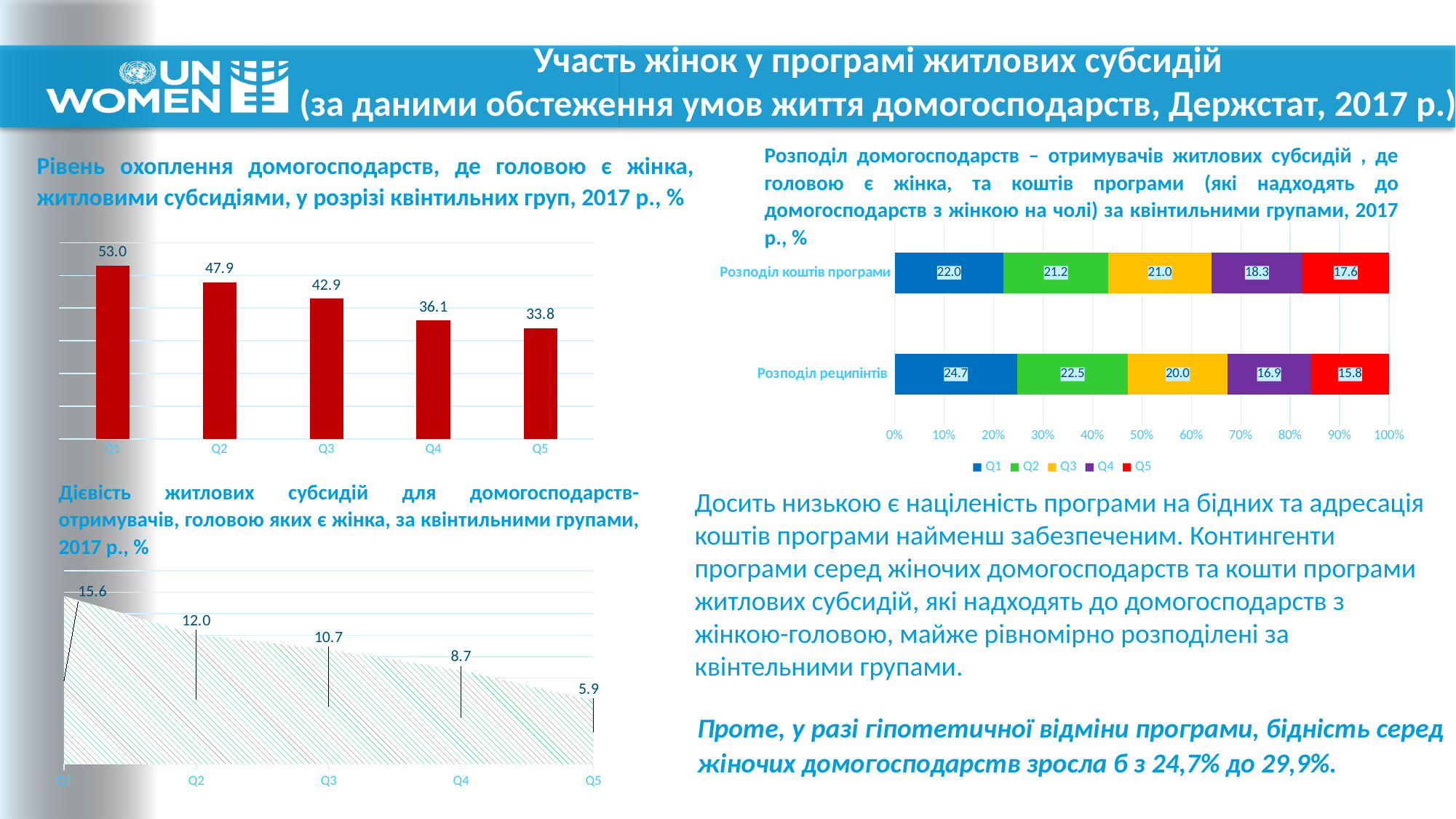
In the bottom-left chart, what is the difference between the values for Q2 and Q4? 3.3 How many categories are shown in the top-left bar chart? 5 In the bottom-left chart, what is the value for Q3? 10.7 In the top-left bar chart, what is the value for Q1? 53.0 In the top-left bar chart, which quintile group has the lowest value? Q5 What type of chart is the top-left chart? bar chart How many series does the legend of the top-right stacked bar chart list? 5 In the top-left bar chart, what is the difference between the values for Q1 and Q5? 19.2 In the top-left bar chart, do the values rise or fall from Q1 to Q5? fall In the top-right stacked bar chart, which is larger: the Q5 value for 'Розподіл коштів програми' or the Q5 value for 'Розподіл реципієнтів'? Розподіл коштів програми In the bottom-left chart, which quintile group has the highest value? Q1 In the top-right stacked bar chart, what is the Q1 value for 'Розподіл реципієнтів'? 24.7